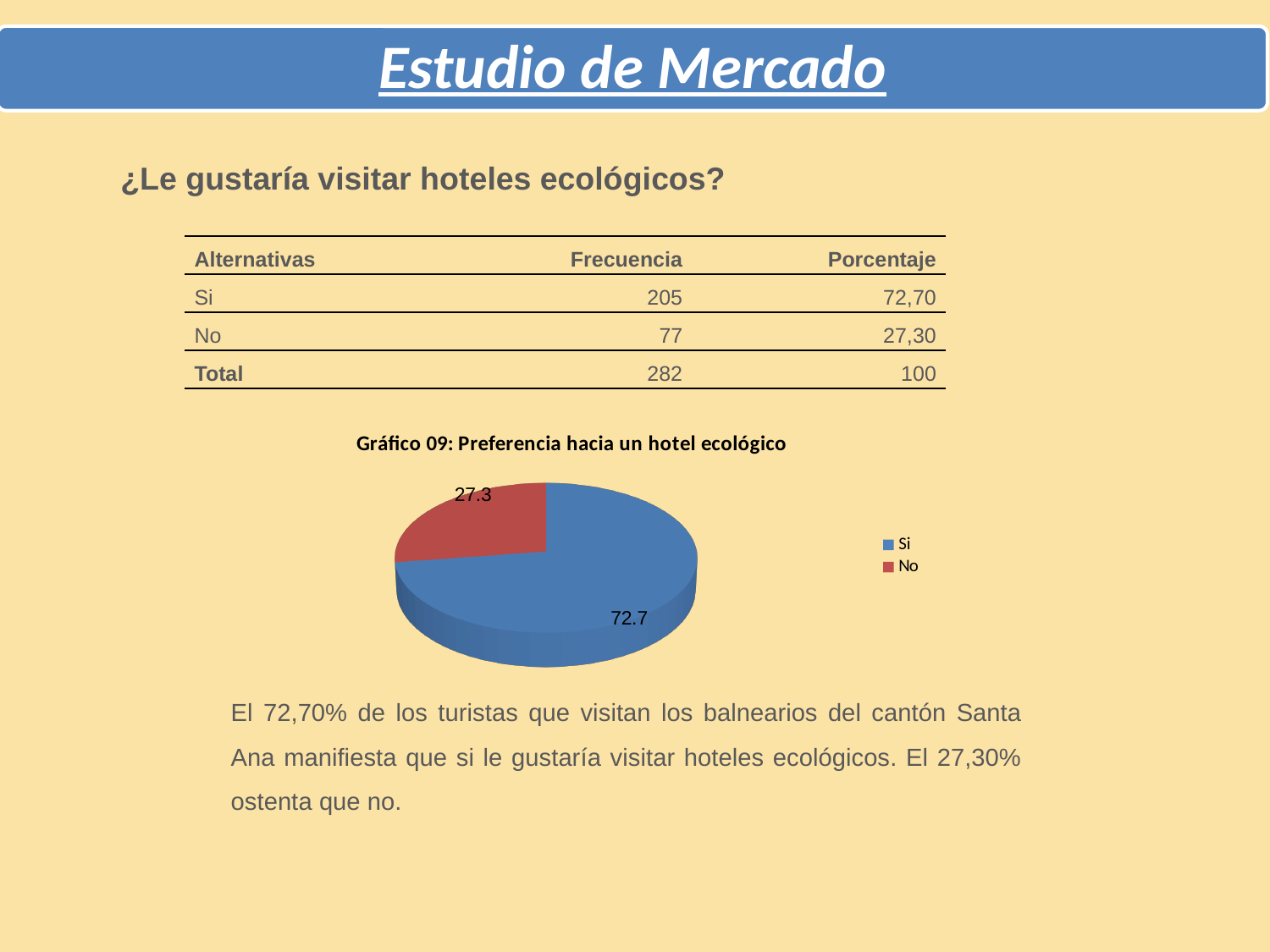
What kind of chart is shown on the slide? Pie chart How many entries does the legend list? 2 What value is shown for the No slice in the pie chart? 27.3 How many slices does the pie chart have? 2 What colour is the Si slice in the pie chart? Blue Which is larger in the pie chart, Si or No? Si Which slice of the pie chart is the largest? Si What value is shown for the Si slice in the pie chart? 72.7 Is the value for No in the pie chart greater or less than 50? less Which slice of the pie chart is the smallest? No What is the chart's title? Gráfico 09: Preferencia hacia un hotel ecológico What is the difference between the Si and No values in the pie chart? 45.4